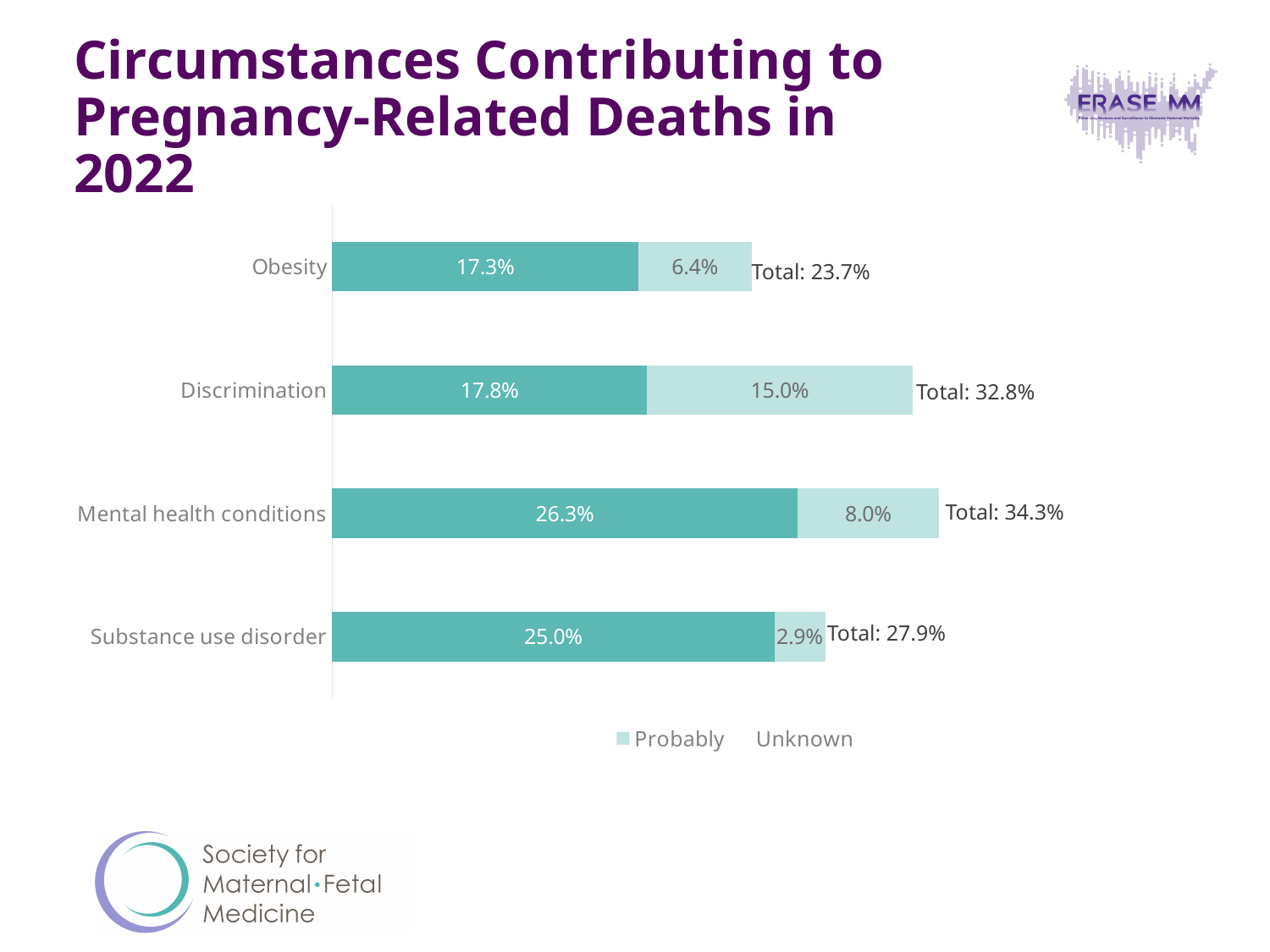
What kind of chart is shown on the slide? Stacked bar chart What are the two series named in the legend? Probably and Unknown Which category has the lowest total? Obesity Which category has the highest total? Mental health conditions What is the difference between the 'Probably' values for Substance use disorder and Obesity? 3.5% How many series does the legend list? 2 What is the total for the Discrimination bar? 32.8% What is the 'Probably' value for Mental health conditions? 8.0% How many categories are shown in the chart? 4